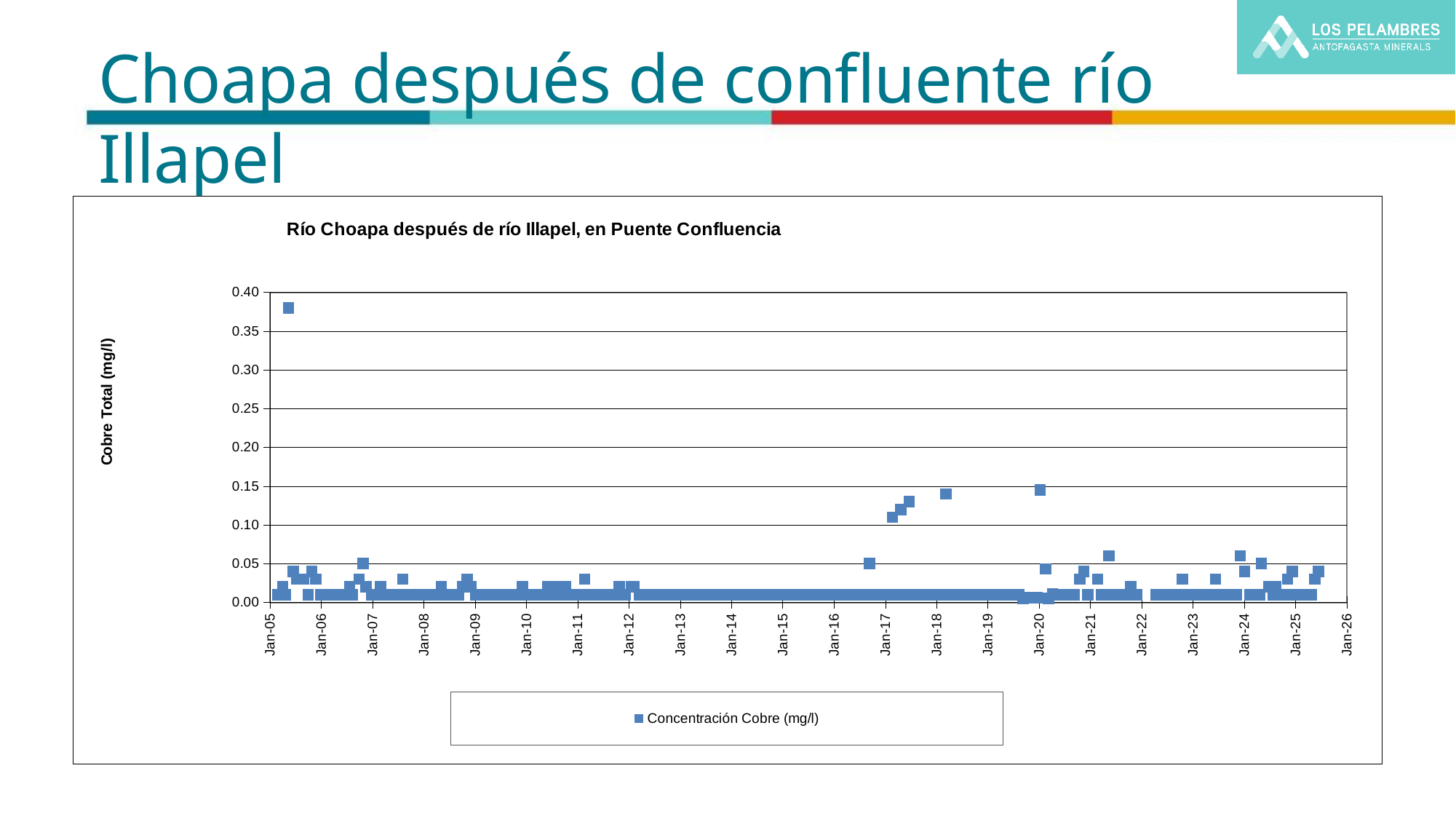
Which is larger: the highest value near Jan-05 or the highest value near Jan-20? the value near Jan-05 Are the values plotted between Jan-13 and Jan-16 greater or less than 0.05? less What is the name of the series shown in the legend? Concentración Cobre (mg/l) Is the value plotted near Jan-20 greater or less than 0.10? greater What is the first year label shown on the horizontal axis? Jan-05 Is the value plotted just after Jan-18 greater or less than 0.10? greater What kind of chart is shown on the slide? scatter chart How many series does the legend list? 1 What is the title of the chart? Río Choapa después de río Illapel, en Puente Confluencia What is the label of the vertical axis? Cobre Total (mg/l)